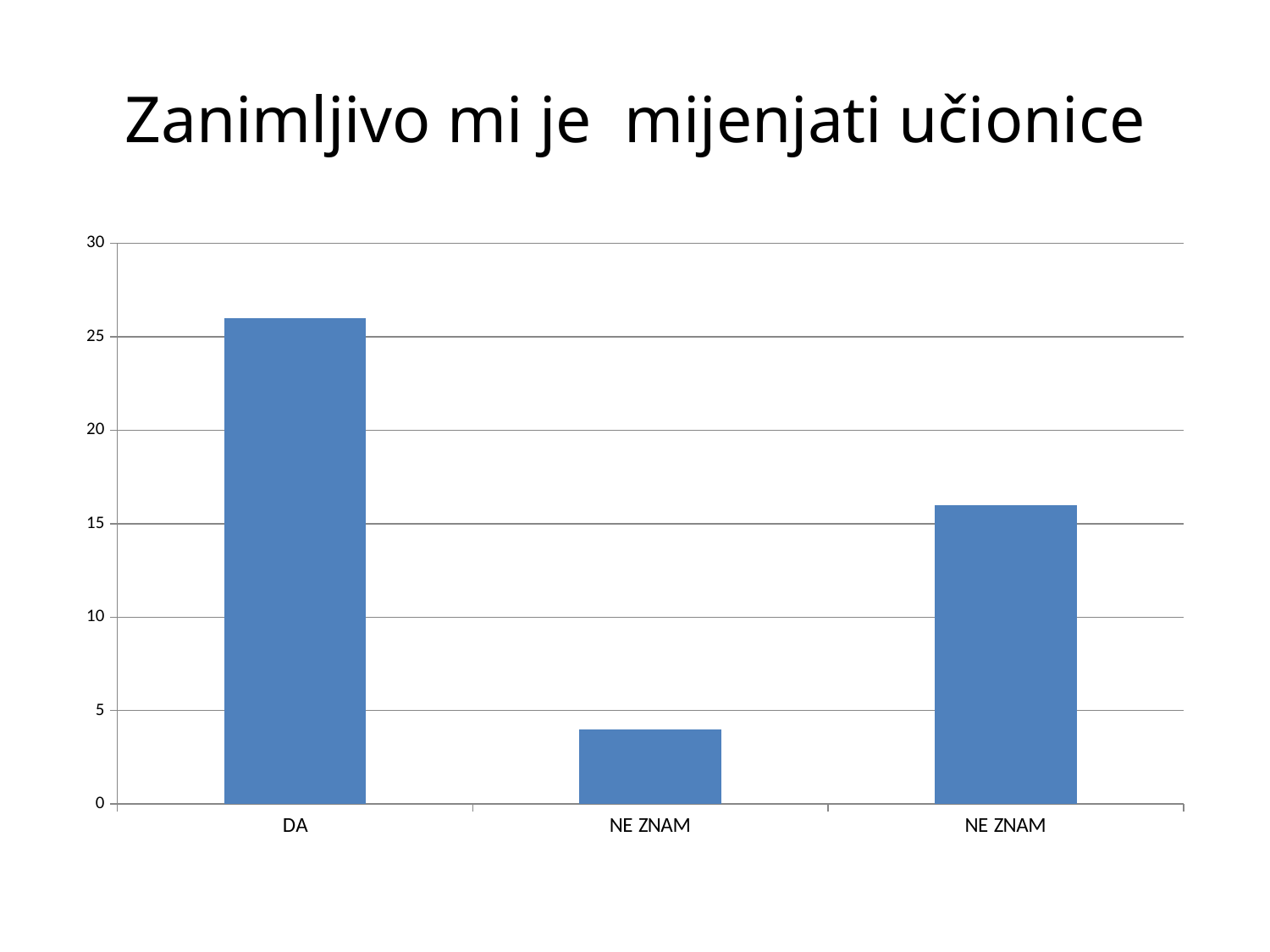
What kind of chart is shown on the slide? bar chart Which bar is the lowest, the one for DA, the middle NE ZNAM bar, or the right NE ZNAM bar? the middle NE ZNAM bar How many bars does the chart show? 3 Which is larger, the middle NE ZNAM bar or the right-hand NE ZNAM bar? the right-hand NE ZNAM bar Which category has the highest bar? DA Is the value for the middle NE ZNAM bar greater or less than 5? less What is the title of the slide? Zanimljivo mi je mijenjati učionice Is the value for the right-hand NE ZNAM bar greater or less than 15? greater Which is larger, the value for DA or the value for the right-hand NE ZNAM bar? DA Is the value for DA greater or less than 30? less What is the highest value shown on the vertical axis? 30